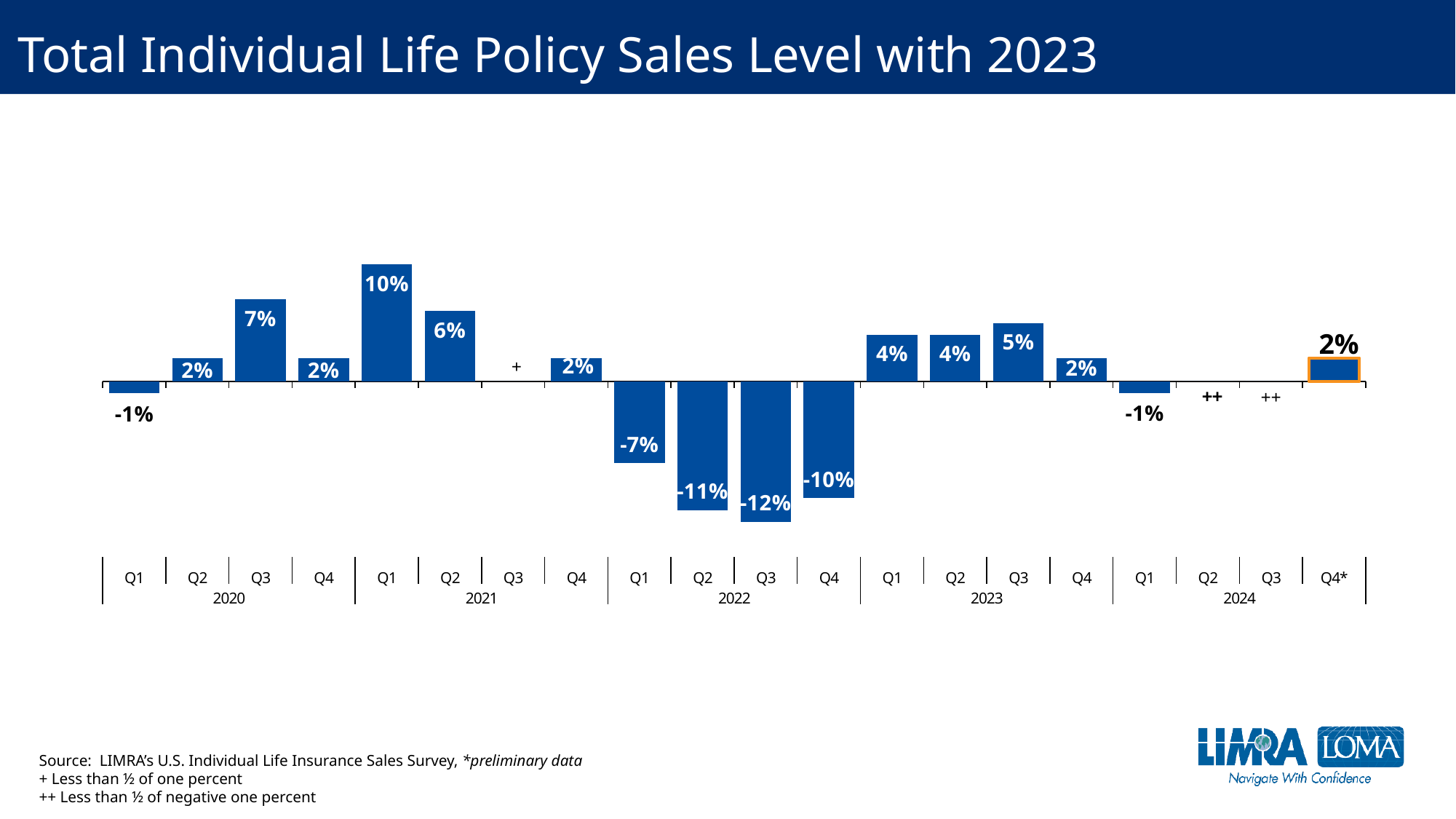
What is the value for Q1 2021? 10% Which quarter has the highest value? Q1 2021 What kind of chart is shown on the slide? Bar chart What is the value for Q3 2023? 5% How many quarters are shown on the x axis? 20 Which quarter has the lowest value? Q3 2022 What is the difference between the values for Q1 2021 and Q2 2021? 4% What is the value for Q3 2022? -12% What is the title of the chart? Total Individual Life Policy Sales Level with 2023 Do the values rise or fall from Q1 2022 to Q3 2022? Fall Which is larger, the value for Q3 2020 or the value for Q2 2021? Q3 2020 What is the value for Q4* 2024? 2%